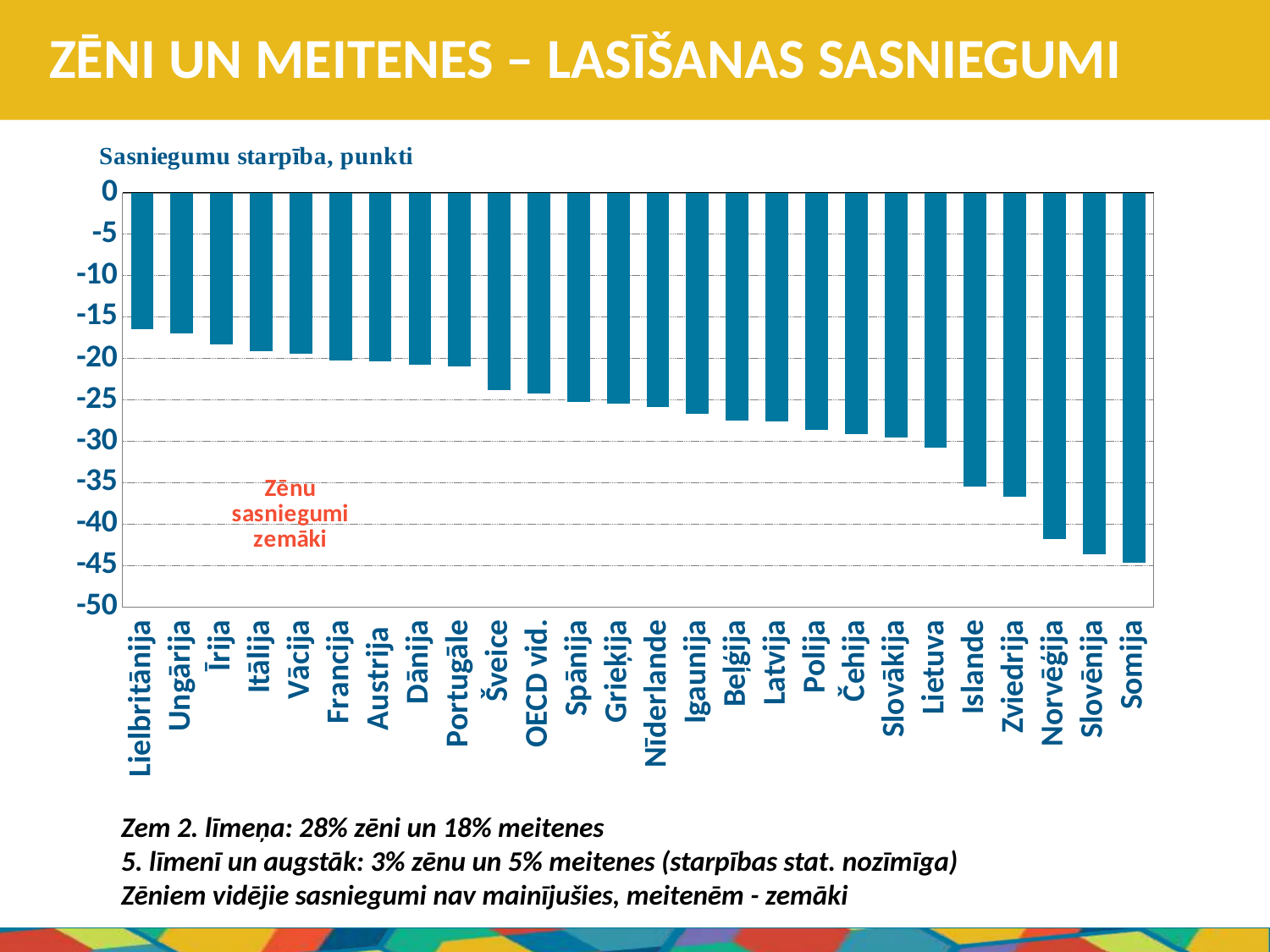
Do the values rise or fall moving from left to right along the x axis? fall Is the value for Somija greater or less than -40? less Which category has the lowest (most negative) value in the chart? Somija Which has the higher value, Ungārija or Lietuva? Ungārija Which category has the highest value (smallest gap) in the chart? Lielbritānija Is the value for Zviedrija greater or less than -35? less Which has the more negative value, Latvija or Somija? Somija What kind of chart is shown on the slide? bar chart How many categories (bars) are plotted in the chart? 26 Is the value for Norvēģija greater or less than -40? less What is the title shown above the chart's y axis? Sasniegumu starpība, punkti